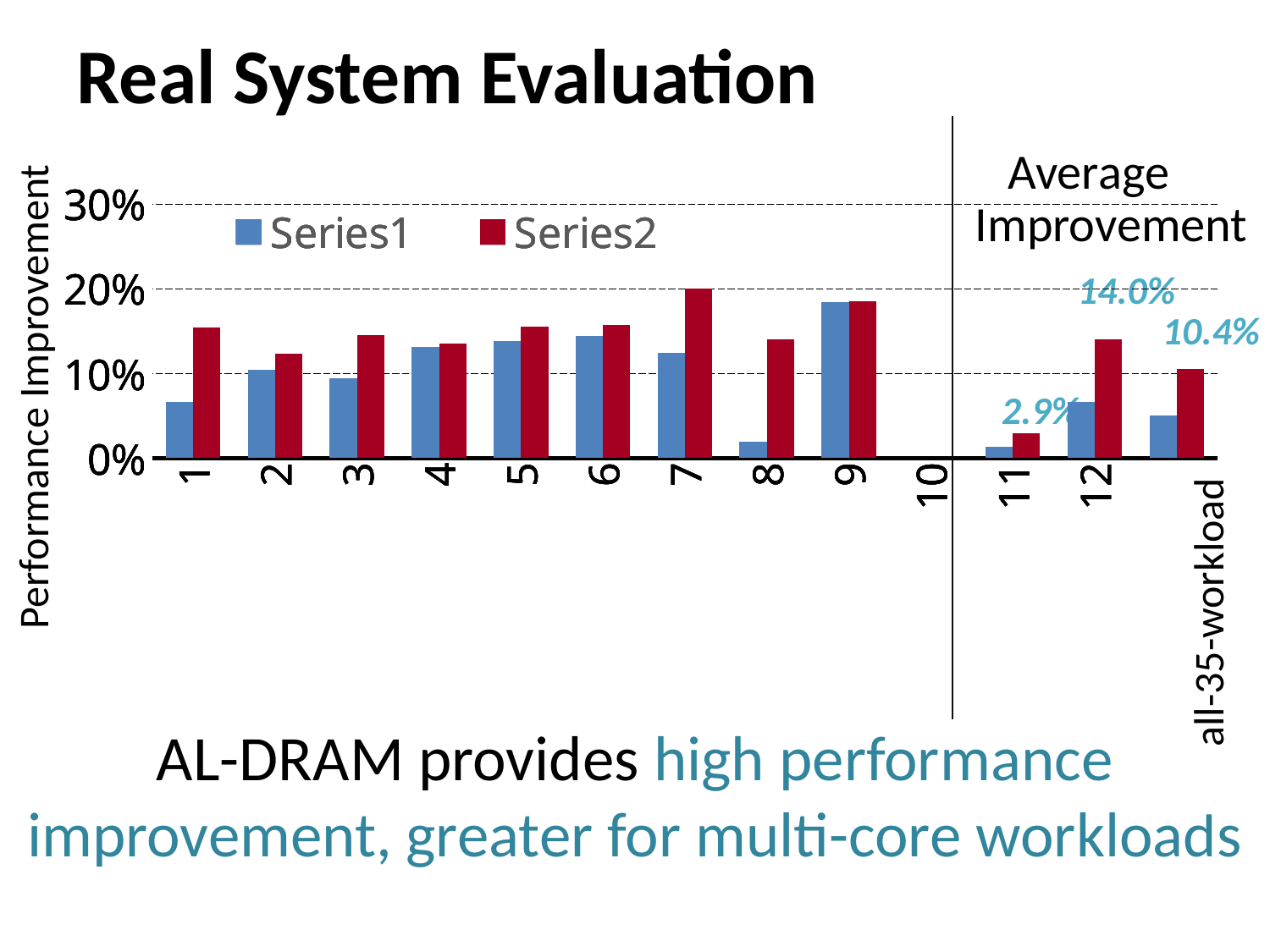
What is the Series2 value for category 12? 14.0% Is the Series2 value for category 7 greater or less than 10%? greater What kind of chart is shown on the slide? bar chart Among categories 1 to 9, which category has the highest Series2 value? 7 What is the Series2 value for category 11? 2.9% What is the difference between the Series2 values for category 12 and all-35-workload? 3.6% Is the Series1 value for category 8 greater or less than 10%? less What is the label on the vertical axis? Performance Improvement For category 7, which series has the larger value, Series1 or Series2? Series2 What is the Series2 value for all-35-workload? 10.4% How many series does the legend list? 2 Which category has the lowest Series2 value? 11